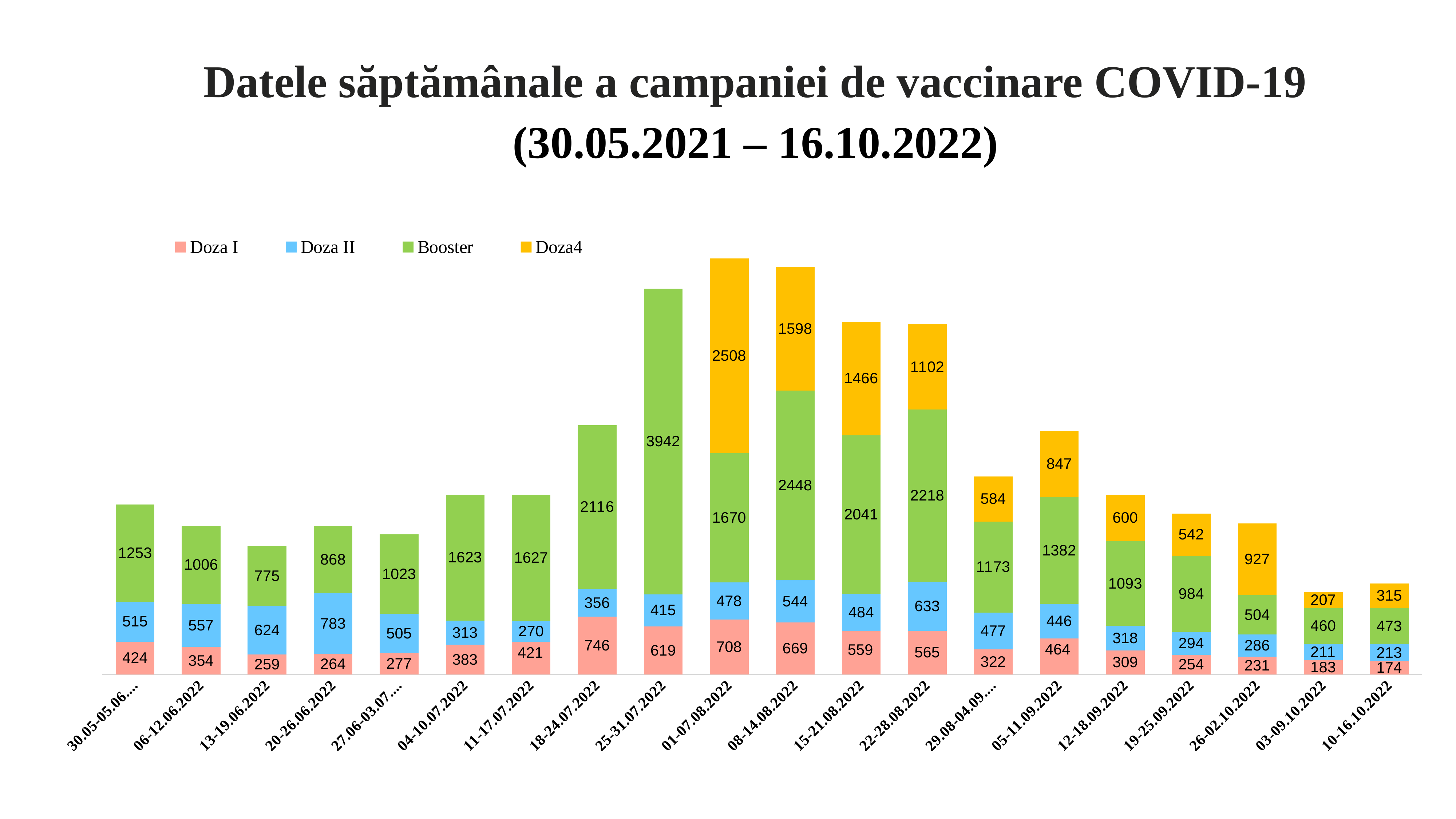
What is the difference between the Doza4 values for 01-07.08.2022 and 08-14.08.2022? 910 What is the Doza II value for the week 22-28.08.2022? 633 How many weeks (categories) are shown on the x axis? 20 What kind of chart is shown on the slide? Stacked bar chart What is the Doza I value for the week 18-24.07.2022? 746 What is the Booster value for the week 25-31.07.2022? 3942 Which week has the larger Doza II value, 13-19.06.2022 or 20-26.06.2022? 20-26.06.2022 How many series does the legend list? 4 Which week has the highest Booster value? 25-31.07.2022 Which week has the lowest Doza I value? 10-16.10.2022 What is the Doza4 value for the week 01-07.08.2022? 2508 What is the total of the stacked bar for the week 10-16.10.2022? 1175